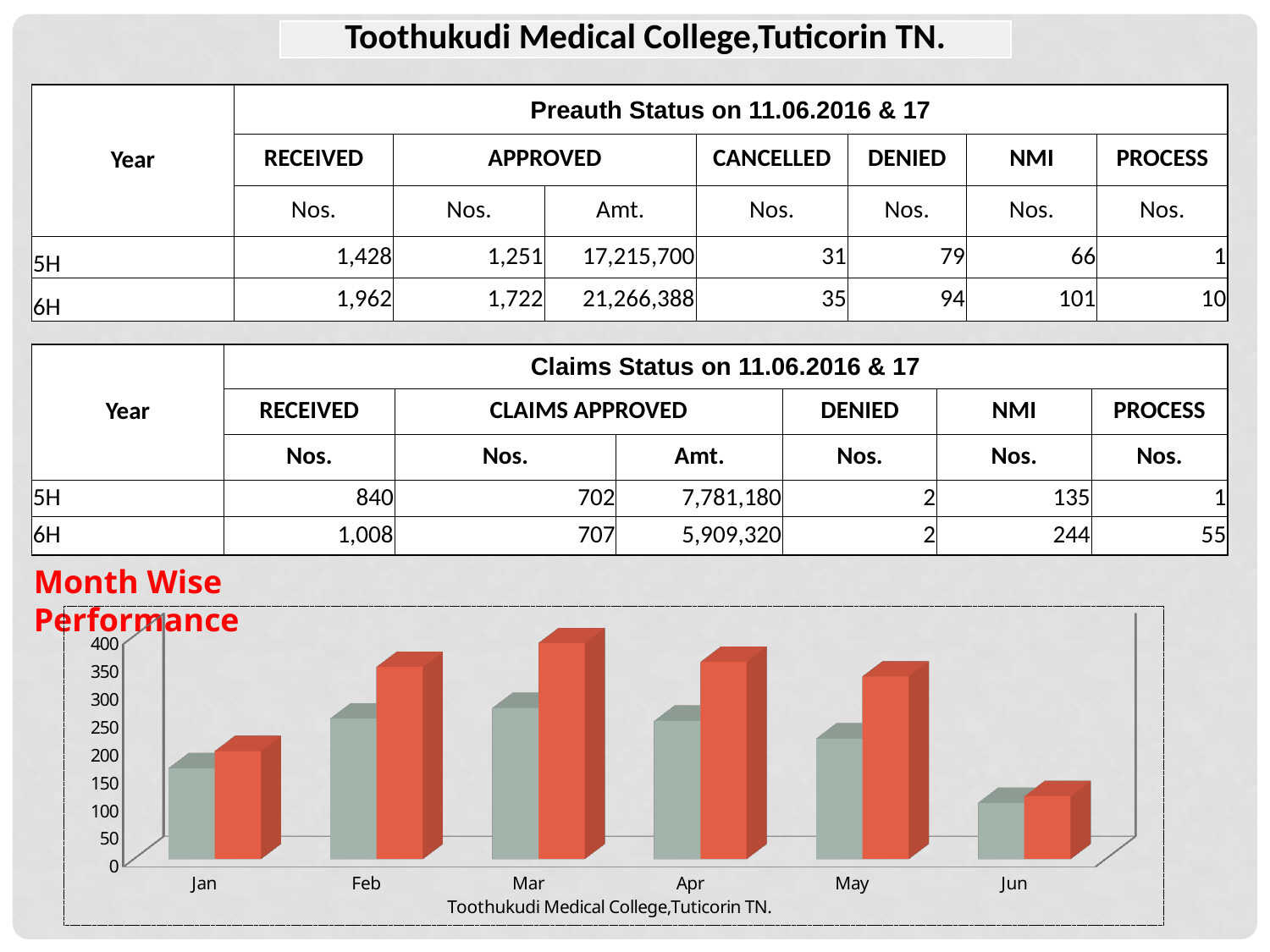
Is the red bar for Mar greater or less than 350? greater In the bar chart, which month has the shortest grey bar? Jun Which is taller in the bar chart: the red bar for Feb or the red bar for Jan? Feb Is the grey bar for Feb greater or less than 200? greater Is the red bar for Jan greater or less than 250? less What kind of chart is shown at the bottom of the slide? bar chart What text appears below the x axis of the bar chart? Toothukudi Medical College,Tuticorin TN. How many months are shown on the x axis of the bar chart? 6 How many bars are plotted for each month in the bar chart? 2 Do the red bars rise or fall from Mar to Jun in the bar chart? fall In the bar chart, which month has the tallest red bar? Mar